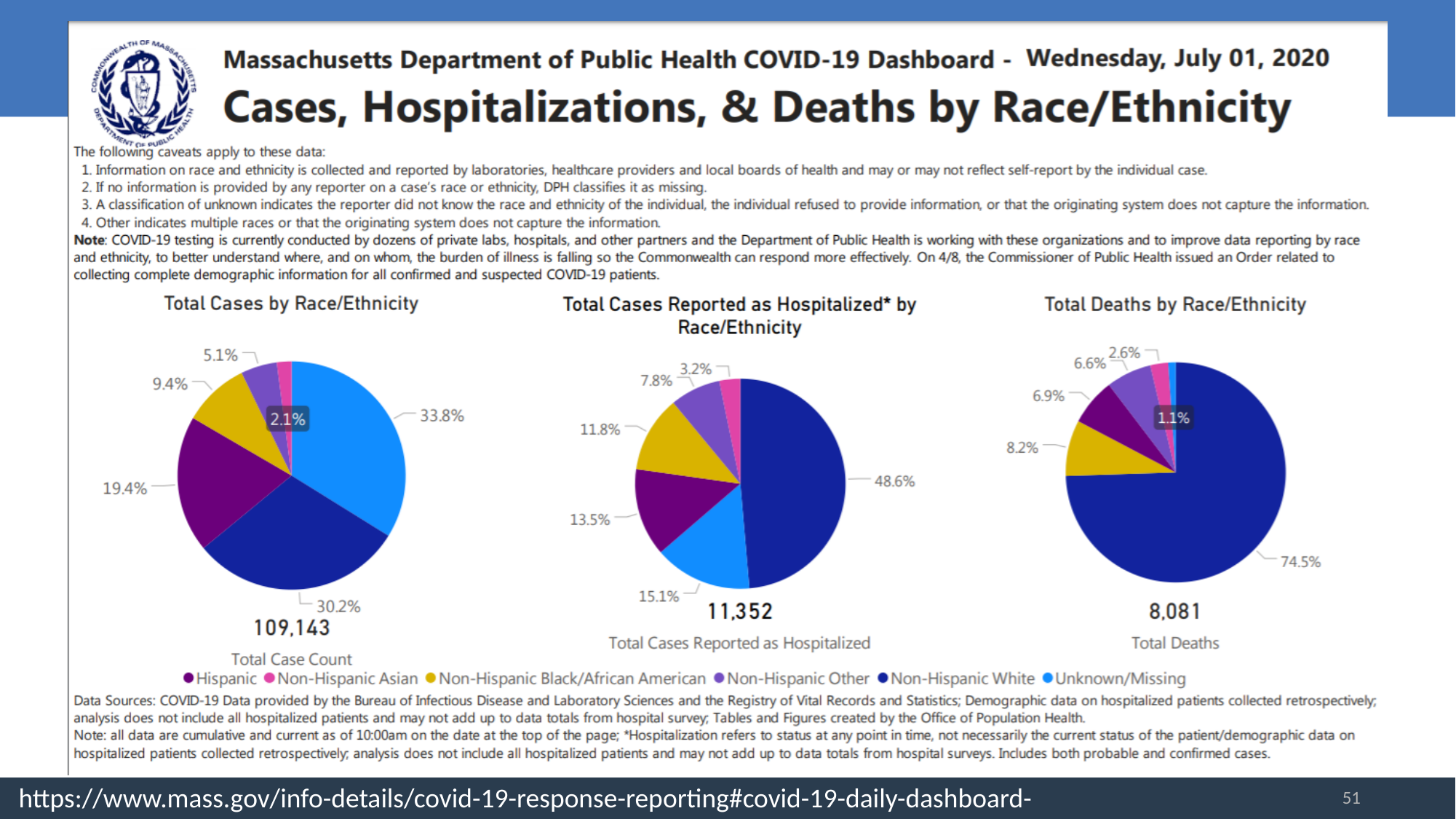
In the Total Cases Reported as Hospitalized by Race/Ethnicity chart, which category has the smallest share? Non-Hispanic Asian In the Total Cases by Race/Ethnicity chart, what share of cases is Unknown/Missing? 33.8% In the Total Deaths by Race/Ethnicity chart, which category has the largest share? Non-Hispanic White What type of chart is used for Total Cases by Race/Ethnicity? Pie chart In the Total Cases Reported as Hospitalized by Race/Ethnicity chart, what is the total number of cases reported as hospitalized? 11,352 In the Total Cases by Race/Ethnicity chart, what share of cases is Hispanic? 19.4% In the Total Cases by Race/Ethnicity chart, what is the total case count shown below the pie? 109,143 In the Total Deaths by Race/Ethnicity chart, what share of deaths is Non-Hispanic White? 74.5% How many categories does the shared legend list for the three pie charts? 6 In the Total Deaths by Race/Ethnicity chart, what is the total number of deaths shown? 8,081 In the Total Deaths by Race/Ethnicity chart, what is the difference between the Non-Hispanic Black/African American share and the Hispanic share? 1.3%